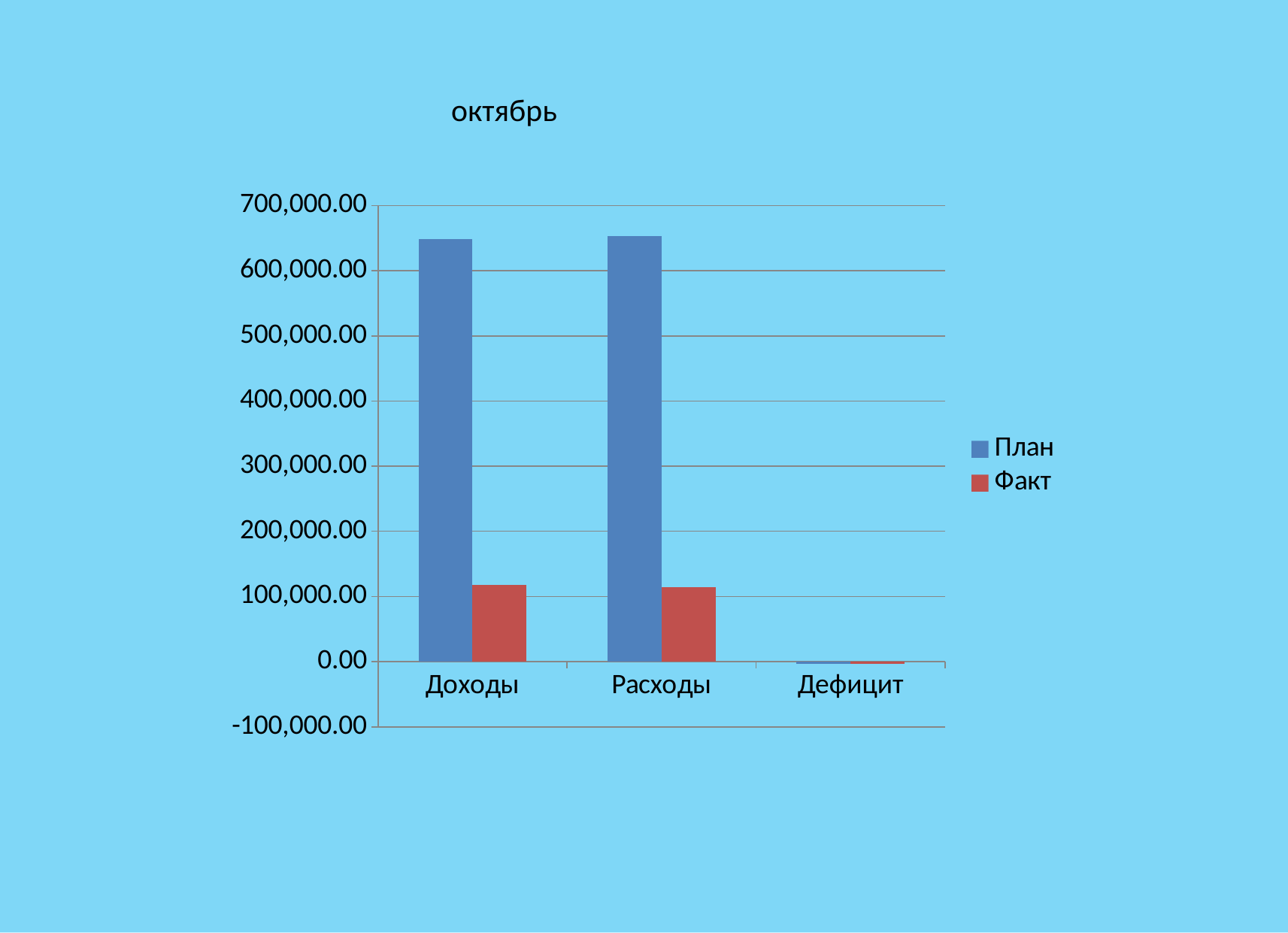
Is the План value for Расходы greater or less than 700,000.00? less Which category has the lowest План value? Дефицит Is the Факт value for Доходы greater or less than 100,000.00? greater What is the title of the chart? октябрь What kind of chart is shown on the slide? bar chart Is the Факт value for Расходы greater or less than 200,000.00? less For Расходы, which is larger: План or Факт? План Which series is shown in red in the legend? Факт For Доходы, which is larger: План or Факт? План How many categories are shown on the x axis? 3 How many series does the legend list? 2